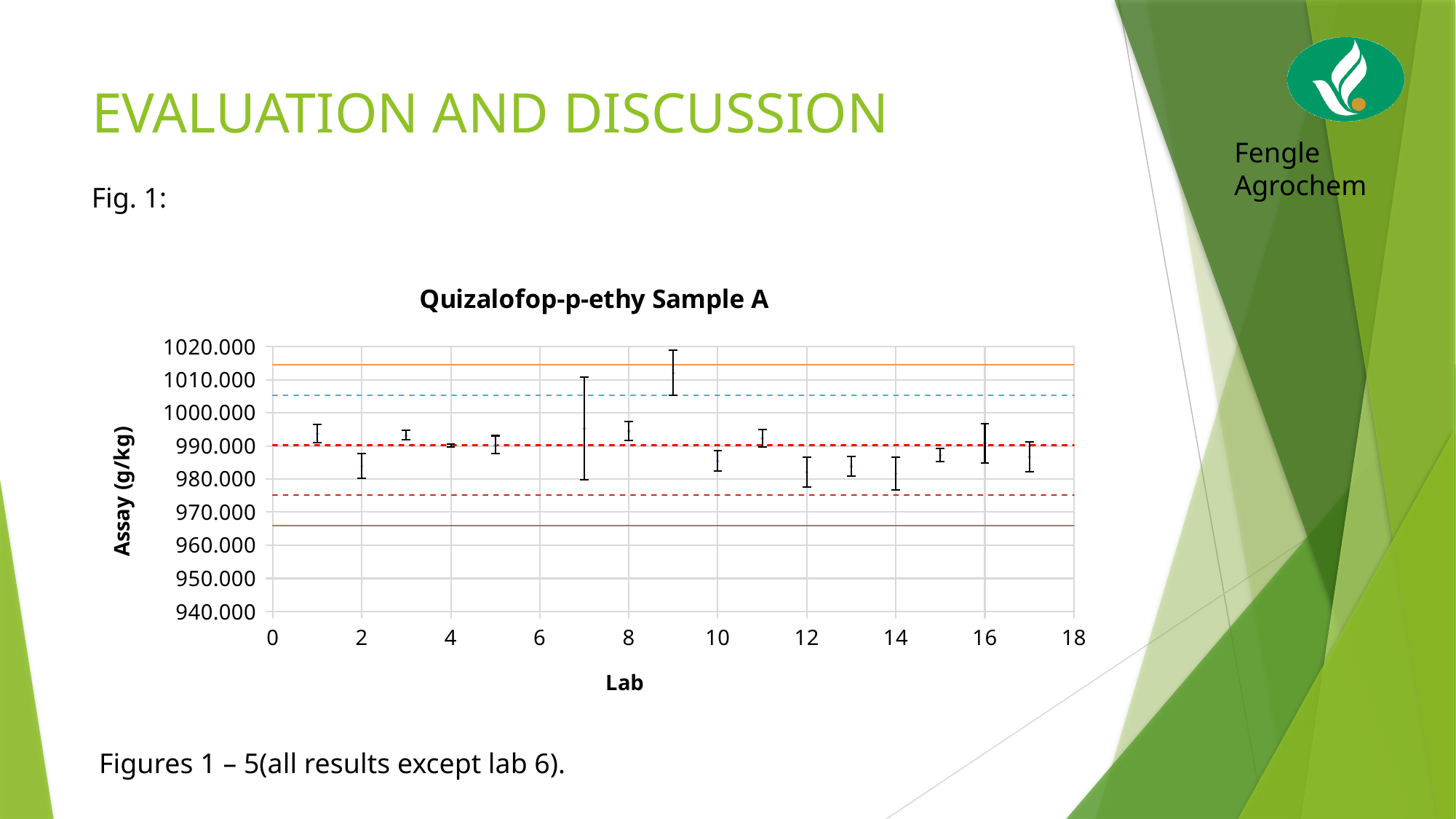
Is the value for Lab 14 greater or less than 990.000? less Is the value for Lab 1 greater or less than 990.000? greater What kind of chart is shown? scatter chart with error bars Is the value for Lab 12 greater or less than 990.000? less Which lab has the highest assay value? Lab 9 What is the title of the chart? Quizalofop-p-ethy Sample A What is the label of the vertical axis? Assay (g/kg) Which has the larger assay value, Lab 1 or Lab 12? Lab 1 How many labs have a result plotted on the chart? 16 Which has the larger assay value, Lab 9 or Lab 2? Lab 9